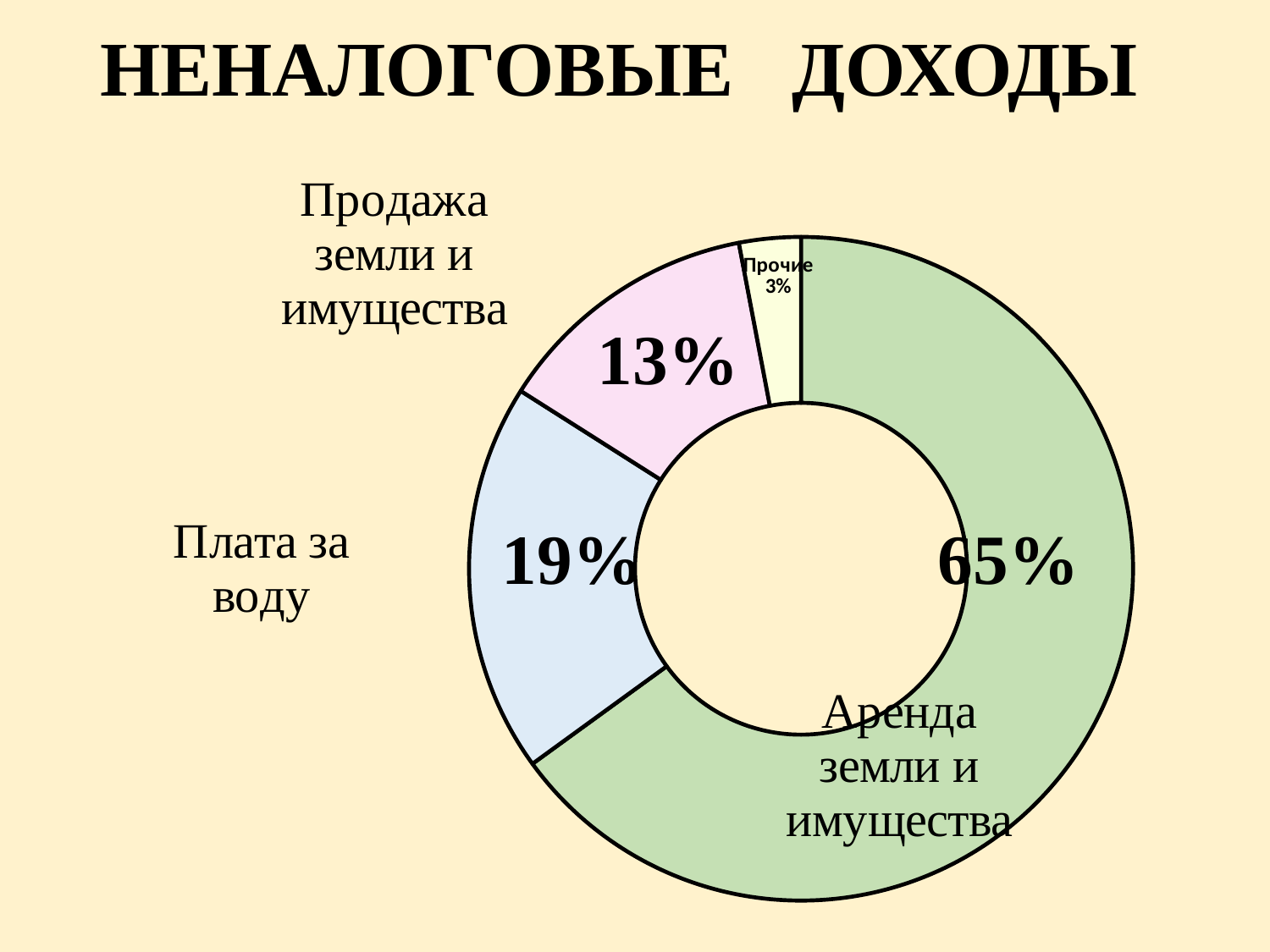
Which category has the largest share of the chart? Аренда земли и имущества Which category has the smallest share of the chart? Прочие What share of non-tax revenues comes from Аренда земли и имущества? 65% What is the difference in percentage points between Плата за воду and Продажа земли и имущества? 6 What percentage is shown for the Прочие segment? 3% How many percentage points larger is Аренда земли и имущества than Плата за воду? 46 How many segments does the chart have? 4 What is the title of the slide? НЕНАЛОГОВЫЕ ДОХОДЫ What share does Плата за воду account for? 19% What kind of chart is shown on the slide? doughnut chart Which is larger, the share for Продажа земли и имущества or the share for Прочие? Продажа земли и имущества What percentage is shown for Продажа земли и имущества? 13%